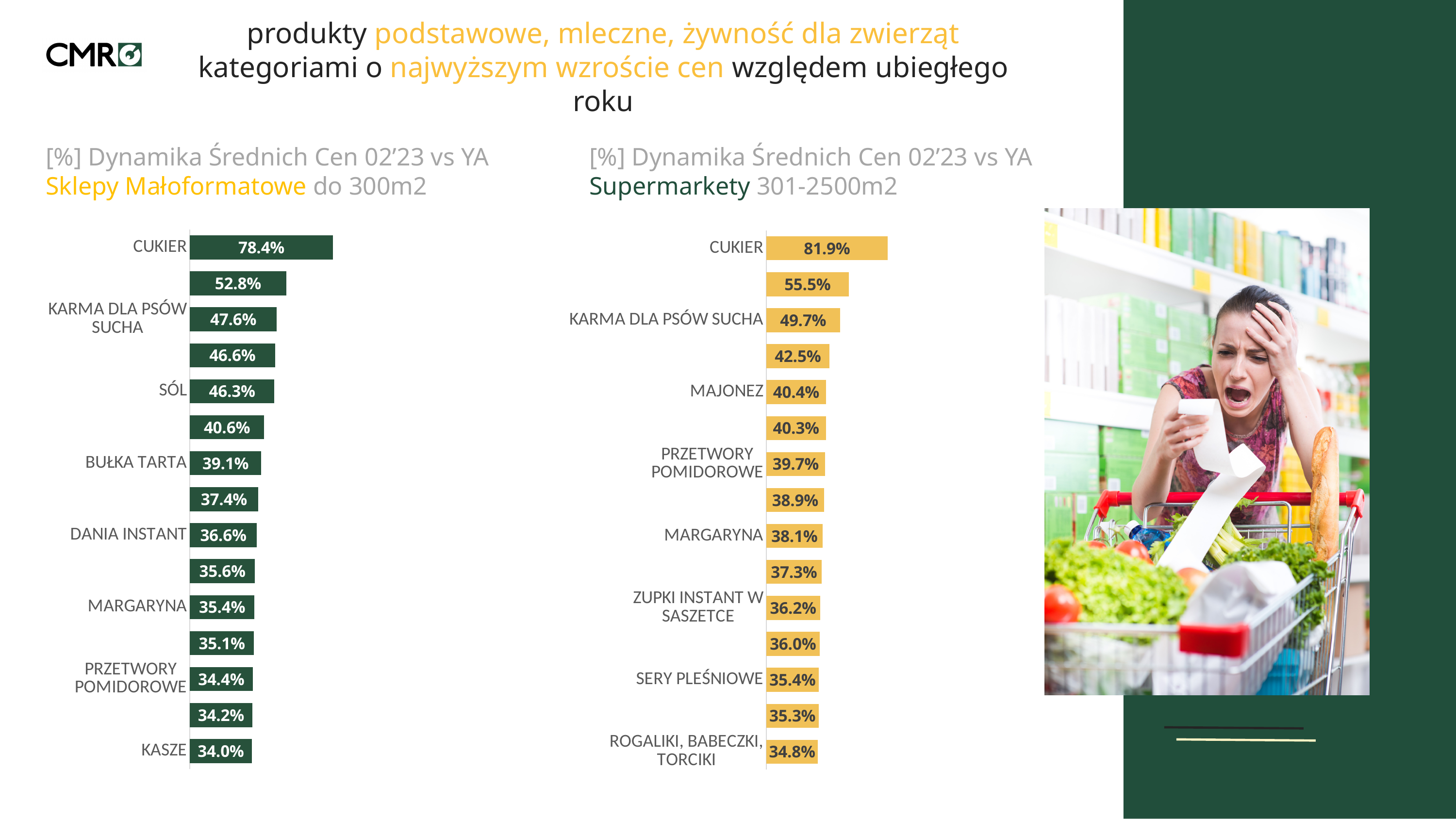
In the Supermarkety chart, what is the value for MAJONEZ? 40.4% In the Supermarkety chart, what is the difference between KARMA DLA PSÓW SUCHA and MARGARYNA? 11.6% In the Supermarkety chart, what is the value for CUKIER? 81.9% Which is larger: MARGARYNA in the Sklepy Małoformatowe chart or MARGARYNA in the Supermarkety chart? Supermarkety In the Sklepy Małoformatowe chart, what is the value for SÓL? 46.3% How many bars are plotted in the Supermarkety chart? 15 In the Sklepy Małoformatowe chart, what is the value for CUKIER? 78.4% In the Supermarkety chart, what is the value for SERY PLEŚNIOWE? 35.4% In the Sklepy Małoformatowe chart, which category has the highest value? CUKIER What type of chart is the Sklepy Małoformatowe chart? Bar chart In the Sklepy Małoformatowe chart, which labelled category has the lowest value? KASZE What is the difference between the CUKIER values in the Supermarkety chart and the Sklepy Małoformatowe chart? 3.5%